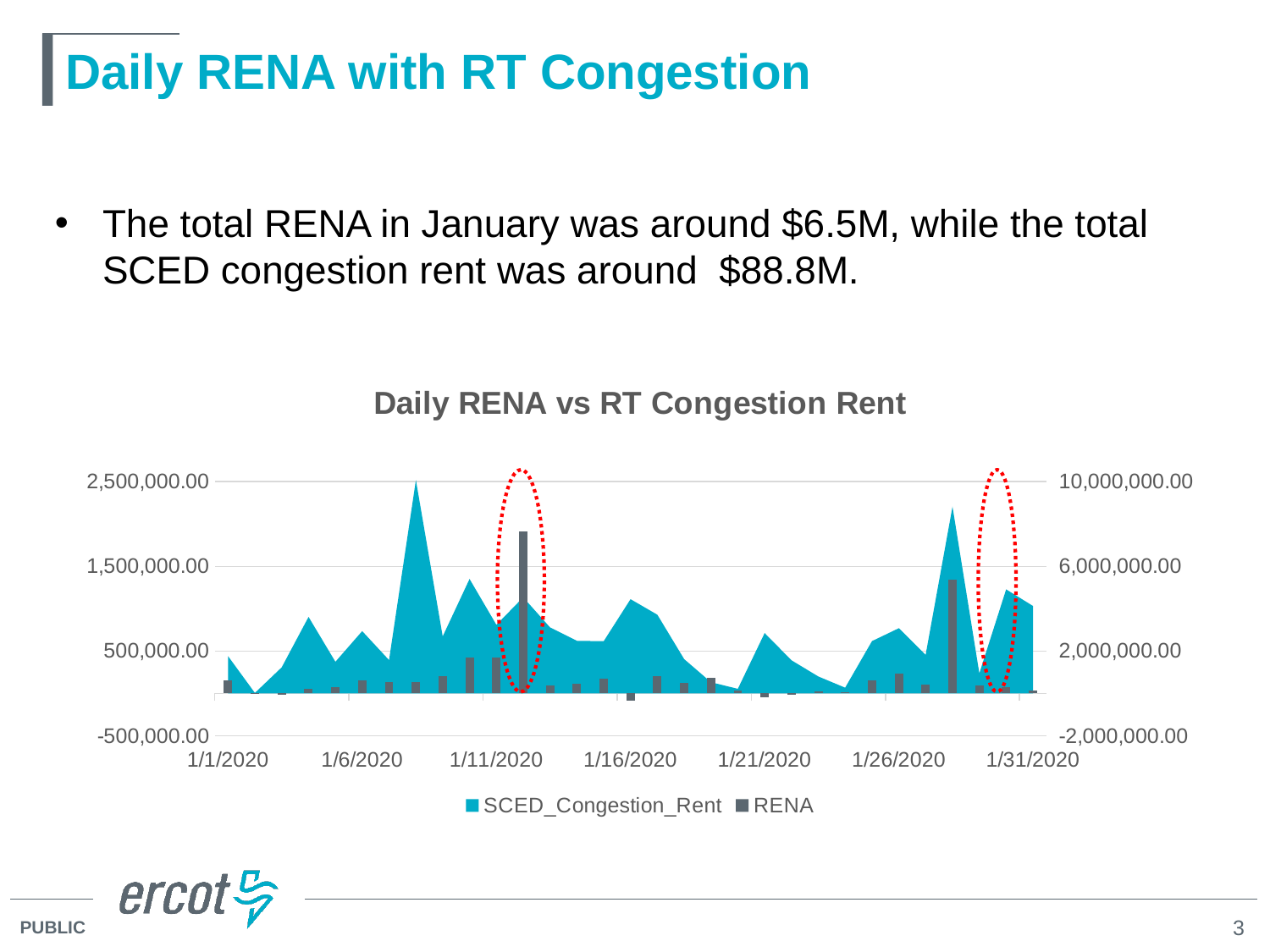
What is the first date label on the x axis of the chart? 1/1/2020 What kind of chart is shown on the slide? A combination chart with an area series and a bar series What is the lowest tick value shown on the right y axis of the chart? -2,000,000.00 What is the last date label on the x axis of the chart? 1/31/2020 How many date labels are shown along the x axis of the chart? 7 How many series does the chart legend list? 2 What is the highest tick value shown on the right y axis of the chart? 10,000,000.00 What is the title of the chart? Daily RENA vs RT Congestion Rent What are the two series named in the chart legend? SCED_Congestion_Rent and RENA What is the highest tick value shown on the left y axis of the chart? 2,500,000.00